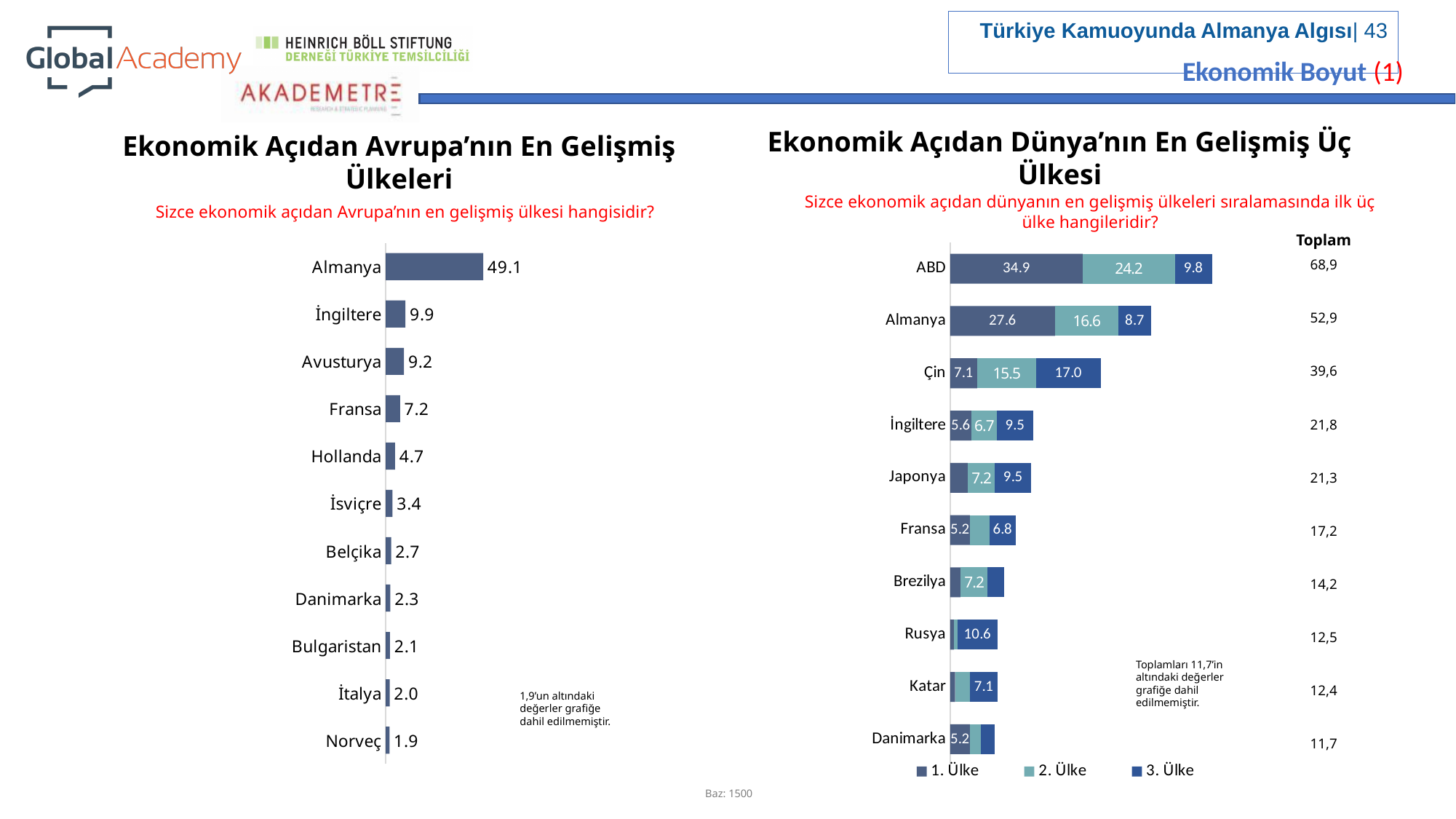
In the right chart (Ekonomik Açıdan Dünya'nın En Gelişmiş Üç Ülkesi), what is the 1. Ülke value for ABD? 34.9 In the left chart (Ekonomik Açıdan Avrupa'nın En Gelişmiş Ülkeleri), how many countries are shown? 11 In the right chart (Ekonomik Açıdan Dünya'nın En Gelişmiş Üç Ülkesi), how many series does the legend list? 3 In the right chart (Ekonomik Açıdan Dünya'nın En Gelişmiş Üç Ülkesi), what is the 3. Ülke value for Çin? 17.0 In the right chart (Ekonomik Açıdan Dünya'nın En Gelişmiş Üç Ülkesi), which is larger: the 2. Ülke value for ABD or the 2. Ülke value for Almanya? ABD What kind of chart is the left chart (Ekonomik Açıdan Avrupa'nın En Gelişmiş Ülkeleri)? Bar chart In the right chart (Ekonomik Açıdan Dünya'nın En Gelişmiş Üç Ülkesi), which country has the highest Toplam? ABD In the right chart (Ekonomik Açıdan Dünya'nın En Gelişmiş Üç Ülkesi), what is the Toplam for Almanya? 52,9 In the left chart (Ekonomik Açıdan Avrupa'nın En Gelişmiş Ülkeleri), what is the value for Almanya? 49.1 In the left chart (Ekonomik Açıdan Avrupa'nın En Gelişmiş Ülkeleri), which country has the lowest value? Norveç In the left chart (Ekonomik Açıdan Avrupa'nın En Gelişmiş Ülkeleri), which country has the highest value? Almanya In the left chart (Ekonomik Açıdan Avrupa'nın En Gelişmiş Ülkeleri), what is the difference between the values for İngiltere and Fransa? 2.7